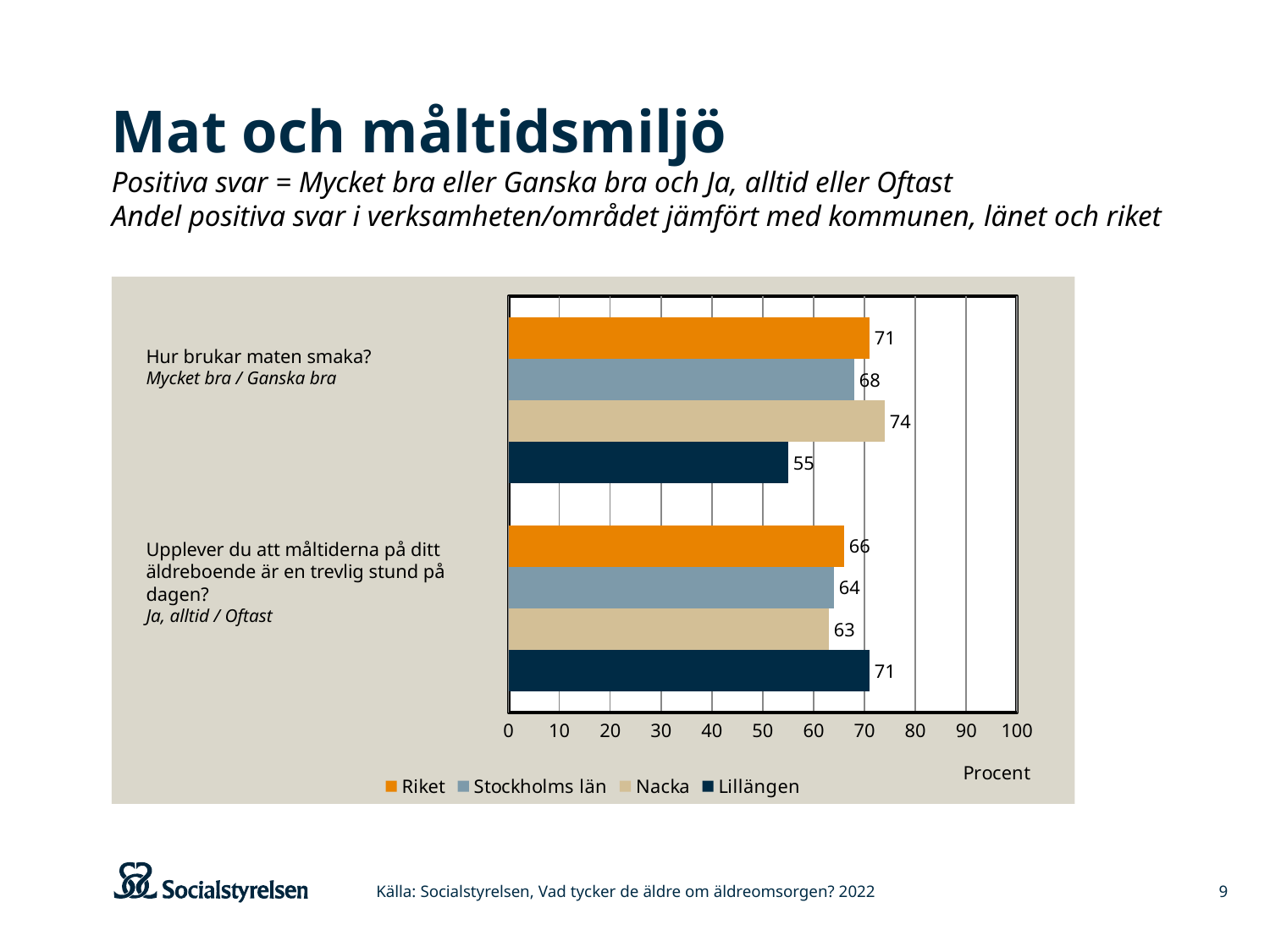
How many series does the legend list? 4 Which series has the lowest value for the question "Upplever du att måltiderna på ditt äldreboende är en trevlig stund på dagen?"? Nacka What is the difference between the Nacka and Lillängen values for the question "Hur brukar maten smaka?"? 19 What is the value for Riket for the question "Upplever du att måltiderna på ditt äldreboende är en trevlig stund på dagen?"? 66 How many question categories are shown on the chart? 2 What is the value for Stockholms län for the question "Upplever du att måltiderna på ditt äldreboende är en trevlig stund på dagen?"? 64 What is the value for Nacka for the question "Hur brukar maten smaka?"? 74 Which series has the highest value for the question "Hur brukar maten smaka?"? Nacka What kind of chart is shown on the slide? Bar chart What is the value for Lillängen for the question "Hur brukar maten smaka?"? 55 What unit is shown on the horizontal axis of the chart? Procent Which is larger for the question "Upplever du att måltiderna på ditt äldreboende är en trevlig stund på dagen?": Lillängen or Riket? Lillängen